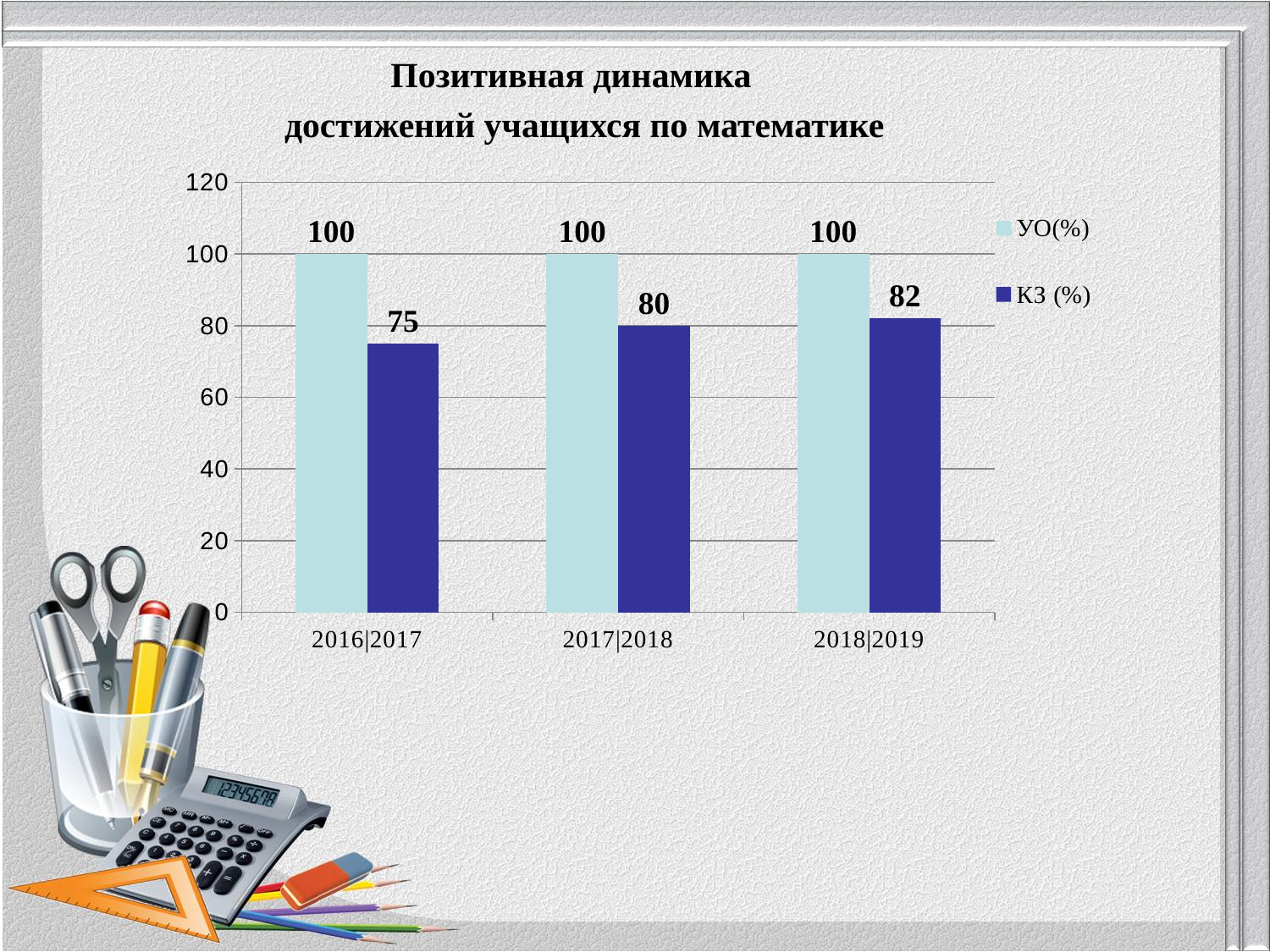
Do the КЗ (%) values rise or fall from 2016|2017 to 2018|2019? Rise How many year categories are shown on the x axis? 3 Which is larger, the КЗ (%) value for 2017|2018 or for 2016|2017? 2017|2018 What is the КЗ (%) value for 2018|2019? 82 How many series does the legend list? 2 What is the УО(%) value for 2017|2018? 100 Which year has the highest КЗ (%) value? 2018|2019 What kind of chart is shown on the slide? Bar chart What is the difference between the КЗ (%) values for 2018|2019 and 2016|2017? 7 What is the КЗ (%) value for 2016|2017? 75 Which year has the lowest КЗ (%) value? 2016|2017 What is the difference between the УО(%) and КЗ (%) values for 2017|2018? 20